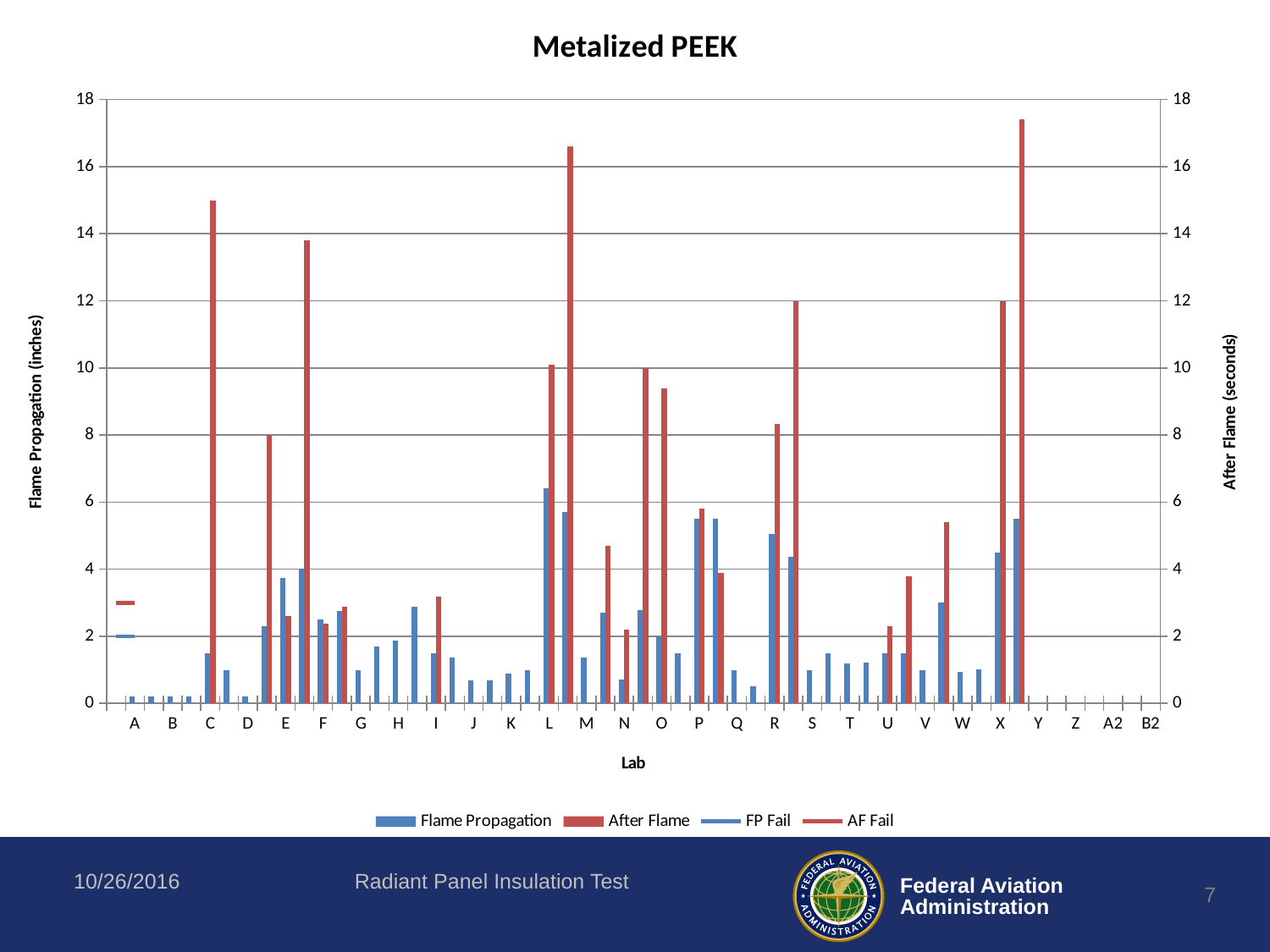
Is the After Flame value for lab C greater or less than 14? greater Is the After Flame value for lab R greater or less than 6? greater Is the Flame Propagation value for lab G greater or less than 2? less What kind of chart is shown on the slide? bar chart For lab C, which is larger, the Flame Propagation value or the After Flame value? After Flame What is the title of the chart? Metalized PEEK How many series does the legend list? 4 What is the label of the left vertical axis? Flame Propagation (inches)